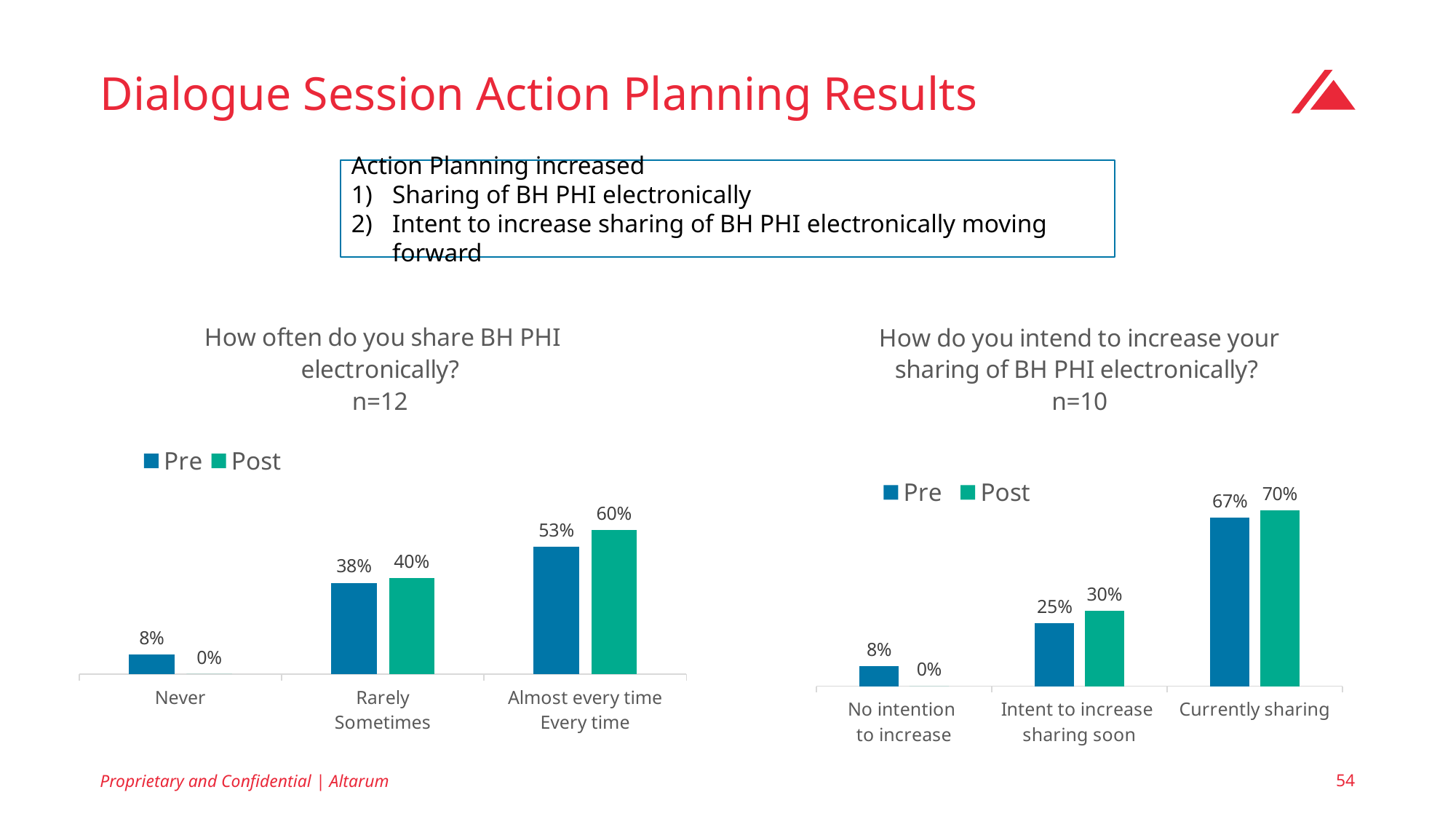
What type of chart is the chart titled "How often do you share BH PHI electronically?"? Bar chart In the chart titled "How do you intend to increase your sharing of BH PHI electronically?", what is the Pre value for "Intent to increase sharing soon"? 25% In the chart titled "How do you intend to increase your sharing of BH PHI electronically?", what is the difference between the Pre values for "Currently sharing" and "Intent to increase sharing soon"? 42% In the chart titled "How often do you share BH PHI electronically?", which category has the highest Post value? Almost every time Every time How many series does the legend list in the chart titled "How do you intend to increase your sharing of BH PHI electronically?"? 2 In the chart titled "How often do you share BH PHI electronically?", what is the Pre value for "Almost every time Every time"? 53% In the chart titled "How often do you share BH PHI electronically?", what is the Post value for "Rarely Sometimes"? 40% In the chart titled "How do you intend to increase your sharing of BH PHI electronically?", what is the Post value for "Currently sharing"? 70% In the chart titled "How often do you share BH PHI electronically?", what is the difference between the Post and Pre values for "Almost every time Every time"? 7% In the chart titled "How do you intend to increase your sharing of BH PHI electronically?", which category has the lowest Pre value? No intention to increase In the chart titled "How do you intend to increase your sharing of BH PHI electronically?", is the Pre value or the Post value larger for "Intent to increase sharing soon"? Post In the chart titled "How often do you share BH PHI electronically?", how many categories are shown on the x axis? 3